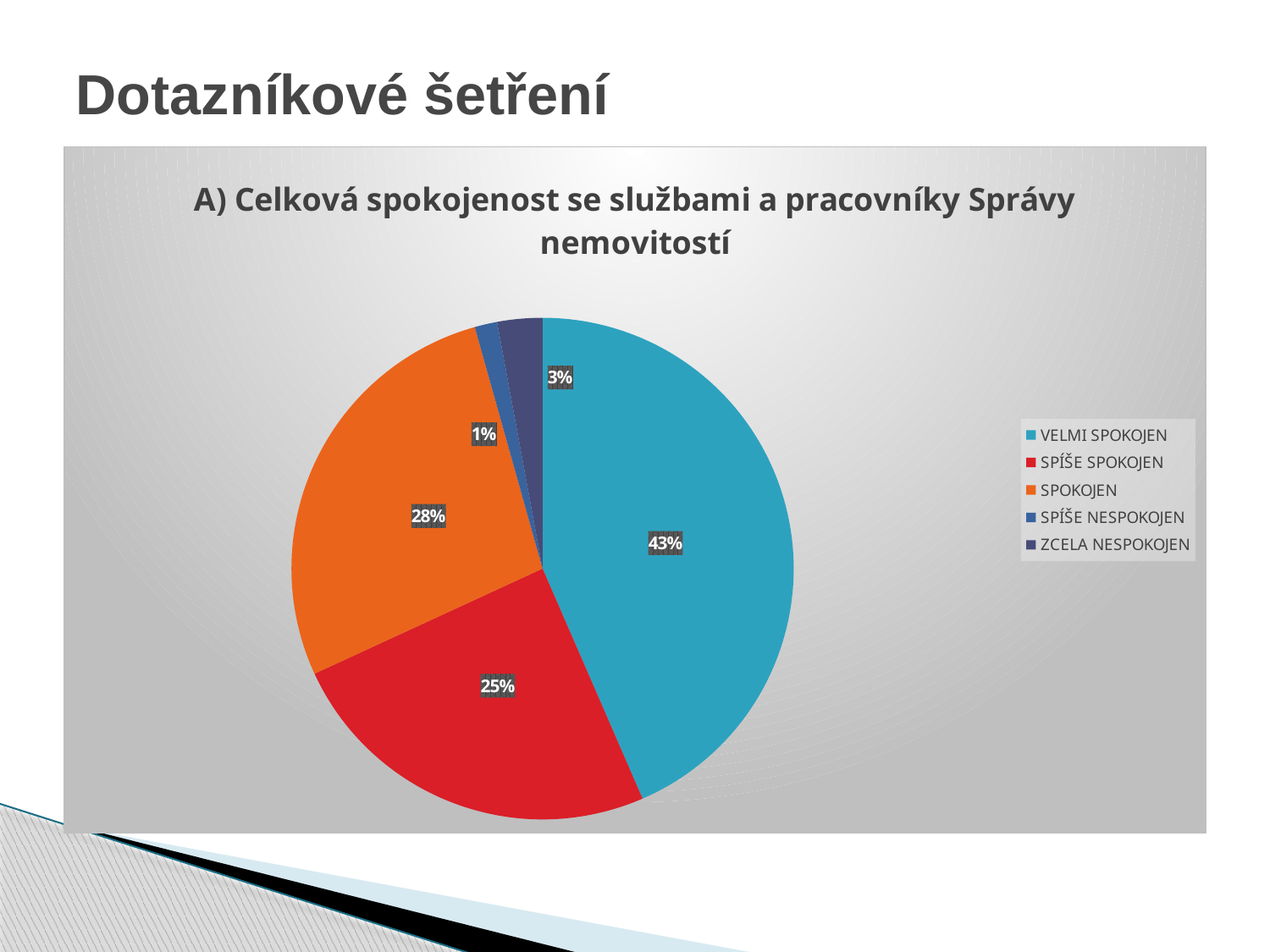
What is the share for SPÍŠE SPOKOJEN? 25% Which category has the smallest slice of the pie? SPÍŠE NESPOKOJEN What is the share for SPOKOJEN? 28% What is the share for ZCELA NESPOKOJEN? 3% Which category has the largest slice of the pie? VELMI SPOKOJEN What is the title of the chart? A) Celková spokojenost se službami a pracovníky Správy nemovitostí How many categories does the legend list? 5 Which is larger, the share for SPOKOJEN or the share for SPÍŠE SPOKOJEN? SPOKOJEN What is the share for SPÍŠE NESPOKOJEN? 1% What is the share for VELMI SPOKOJEN? 43% What is the difference between the shares for VELMI SPOKOJEN and SPOKOJEN? 15% What type of chart is shown on the slide? pie chart